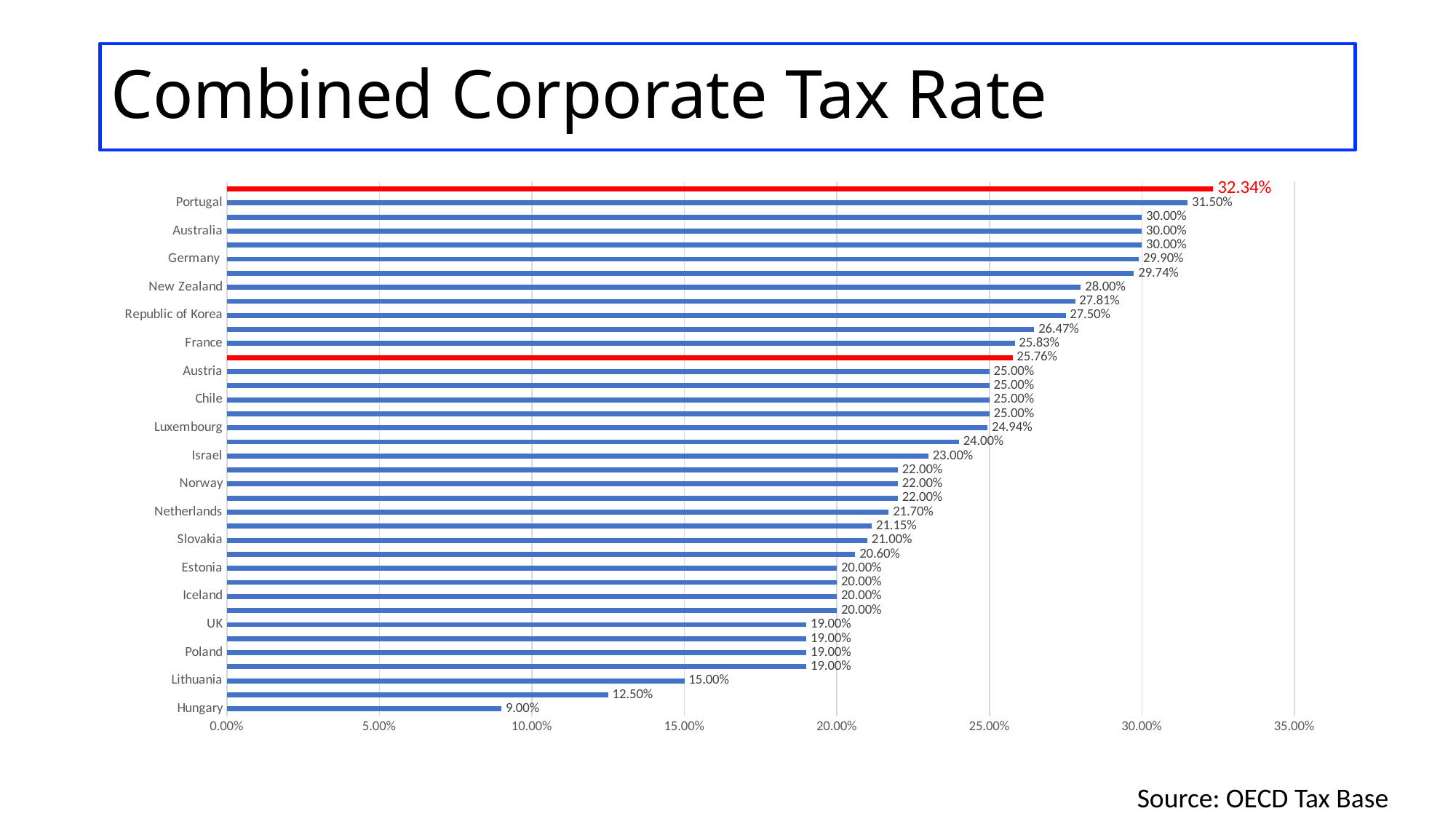
What is the difference between Portugal's rate and Hungary's rate? 22.50% Which labelled country has the lowest combined corporate tax rate? Hungary What is the combined corporate tax rate shown for Lithuania? 15.00% Which has the higher combined corporate tax rate, Germany or New Zealand? Germany What is the combined corporate tax rate shown for France? 25.83% What is the combined corporate tax rate shown for Portugal? 31.50% What is the combined corporate tax rate shown for Germany? 29.90% What is the value of the longest bar in the chart? 32.34% Is the value for Israel greater or less than 25.00%? less What is the combined corporate tax rate shown for Hungary? 9.00% How many bars are coloured red in the chart? 2 What kind of chart is shown on the slide? bar chart